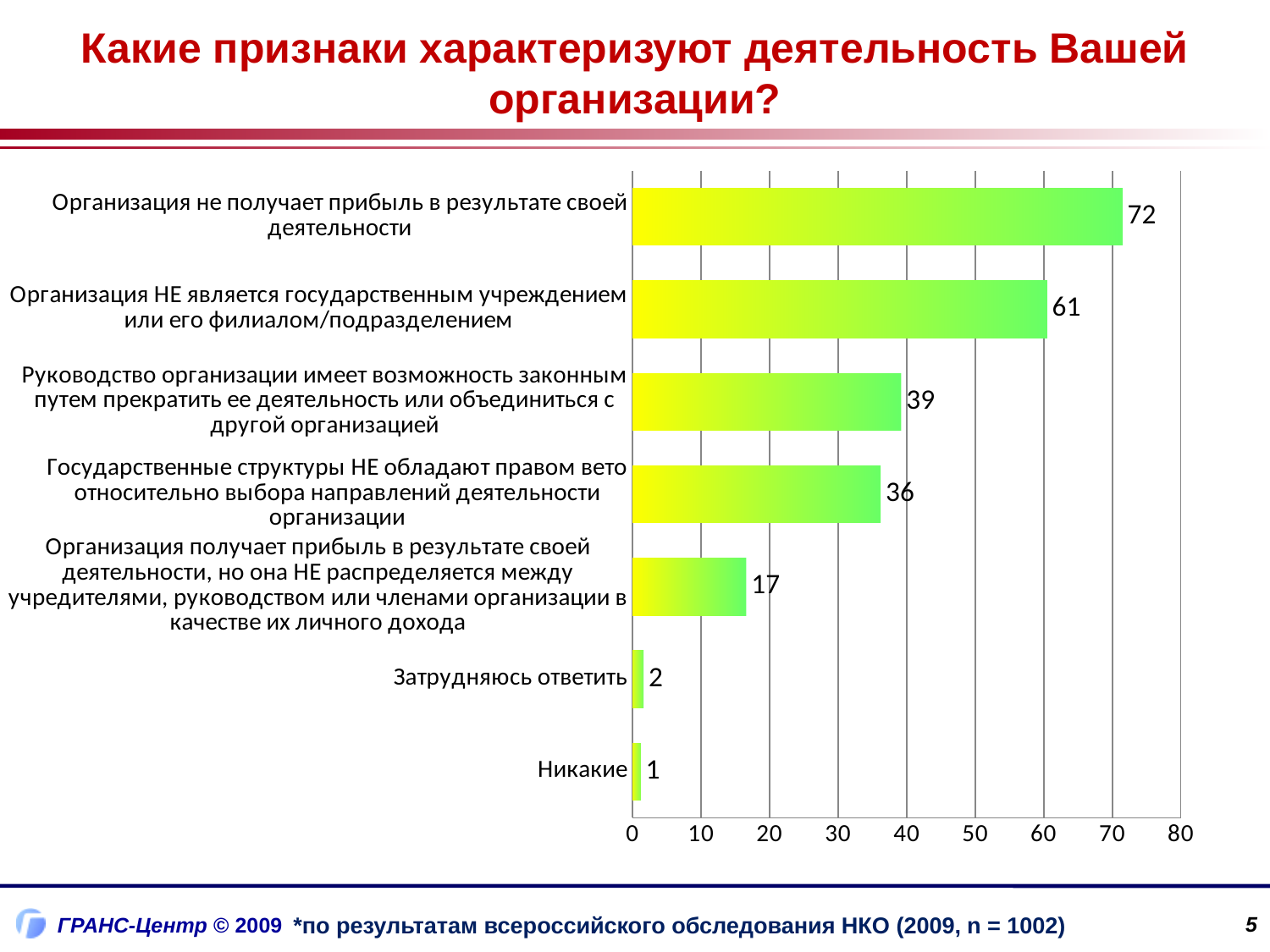
Is the value for "Организация НЕ является государственным учреждением или его филиалом/подразделением" greater or less than 50? greater What kind of chart is shown on the slide? bar chart Which category has the lowest value? Никакие What is the maximum value shown on the horizontal axis? 80 What is the value for "Организация не получает прибыль в результате своей деятельности"? 72 Which is larger: the value for "Руководство организации имеет возможность законным путем прекратить ее деятельность или объединиться с другой организацией" or the value for "Государственные структуры НЕ обладают правом вето относительно выбора направлений деятельности организации"? Руководство организации имеет возможность законным путем прекратить ее деятельность или объединиться с другой организацией What is the value for "Государственные структуры НЕ обладают правом вето относительно выбора направлений деятельности организации"? 36 What is the difference between the values for "Организация не получает прибыль в результате своей деятельности" and "Организация НЕ является государственным учреждением или его филиалом/подразделением"? 11 How many categories are shown in the chart? 7 Which category has the highest value? Организация не получает прибыль в результате своей деятельности What is the value for "Затрудняюсь ответить"? 2 What is the value for "Организация получает прибыль в результате своей деятельности, но она НЕ распределяется между учредителями, руководством или членами организации в качестве их личного дохода"? 17